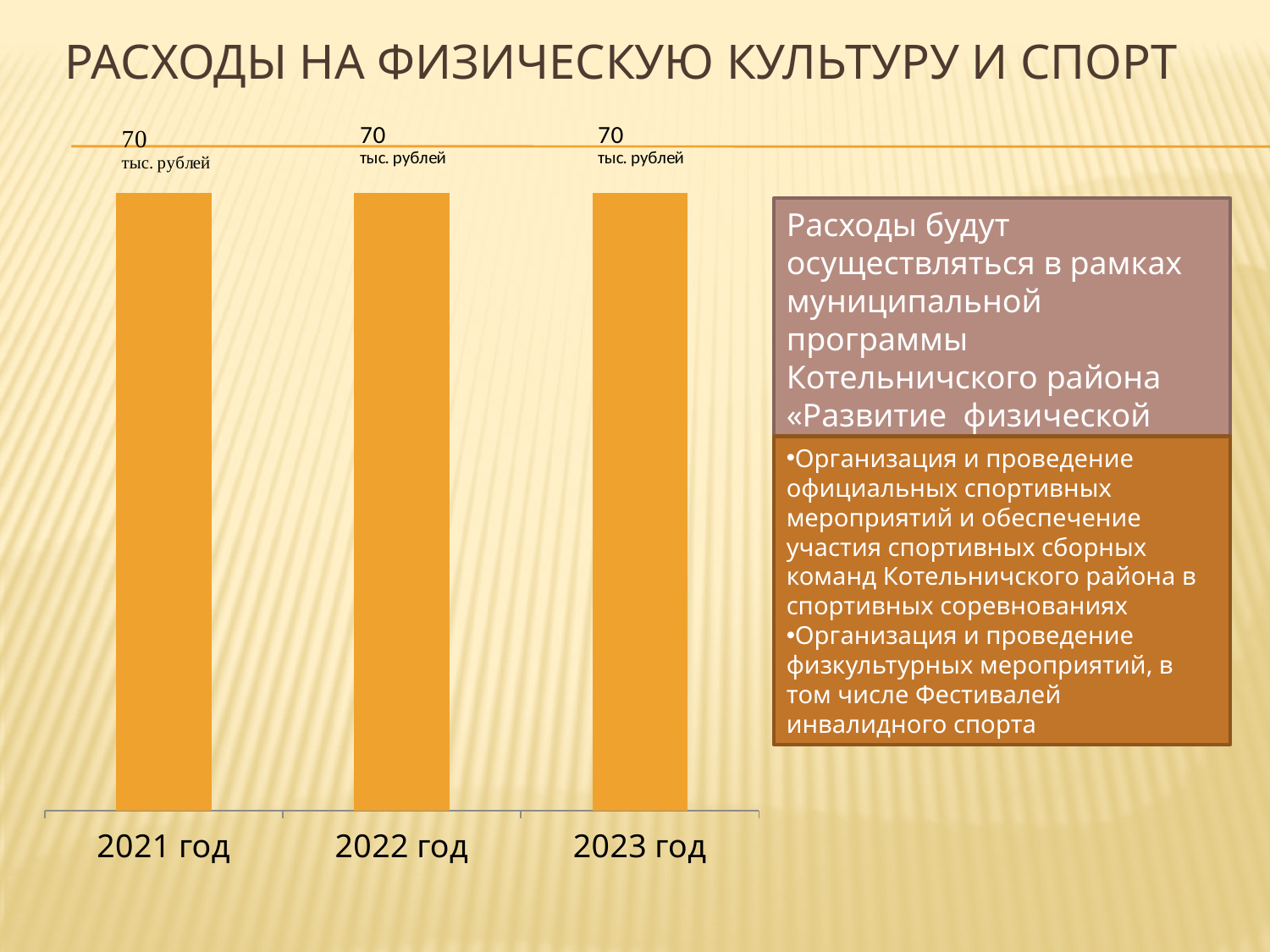
How many categories (years) are shown in the chart? 3 What is the title of the slide containing the chart? РАСХОДЫ НА ФИЗИЧЕСКУЮ КУЛЬТУРУ И СПОРТ In what units are the bar values given? тыс. рублей What is the difference between the values for 2021 год and 2023 год? 0 Is the value for 2022 год larger than, smaller than, or equal to the value for 2021 год? equal What kind of chart is shown on the slide? bar chart What is the value for 2023 год? 70 тыс. рублей Do the values rise, fall, or stay the same from 2021 год to 2023 год? stay the same Which year is the first category on the x axis? 2021 год What is the value for 2022 год? 70 тыс. рублей What is the value for 2021 год? 70 тыс. рублей